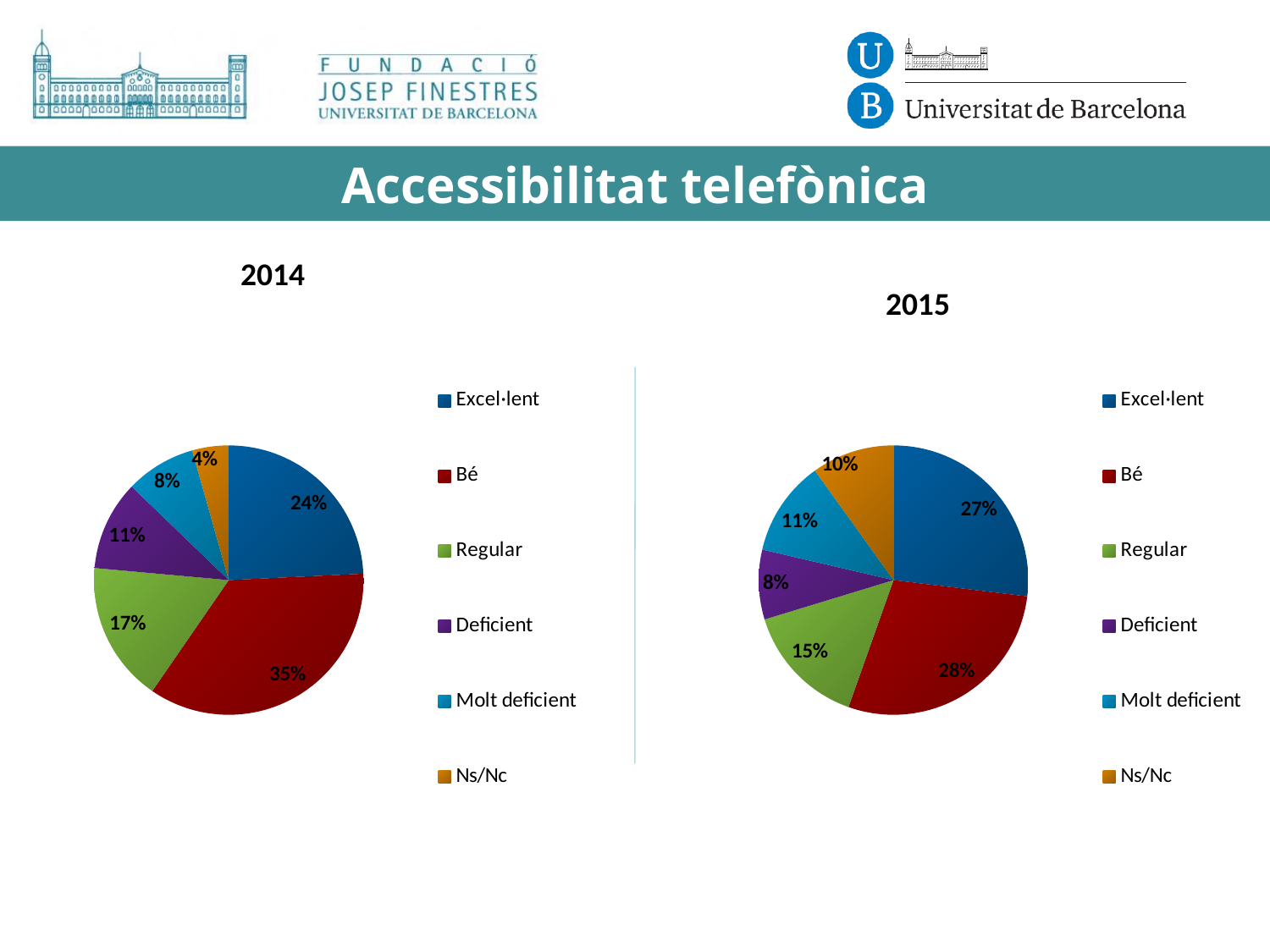
In the 2014 pie chart, which category has the smallest slice? Ns/Nc What type of chart is used for the 2015 data? Pie chart In the 2015 pie chart, which category has the smallest slice? Deficient What is the difference between the Bé share in 2014 and the Bé share in 2015? 7% In the 2014 pie chart, what share does Bé have? 35% How many slices does the 2014 pie chart have? 6 In the 2015 pie chart, what share does Excel·lent have? 27% What colour represents Deficient in the legends of both charts? Purple In the 2014 pie chart, what share does Ns/Nc have? 4% In the 2014 pie chart, which category has the largest slice? Bé In the 2015 pie chart, what share does Molt deficient have? 11% In the 2015 pie chart, which is larger: Regular or Ns/Nc? Regular